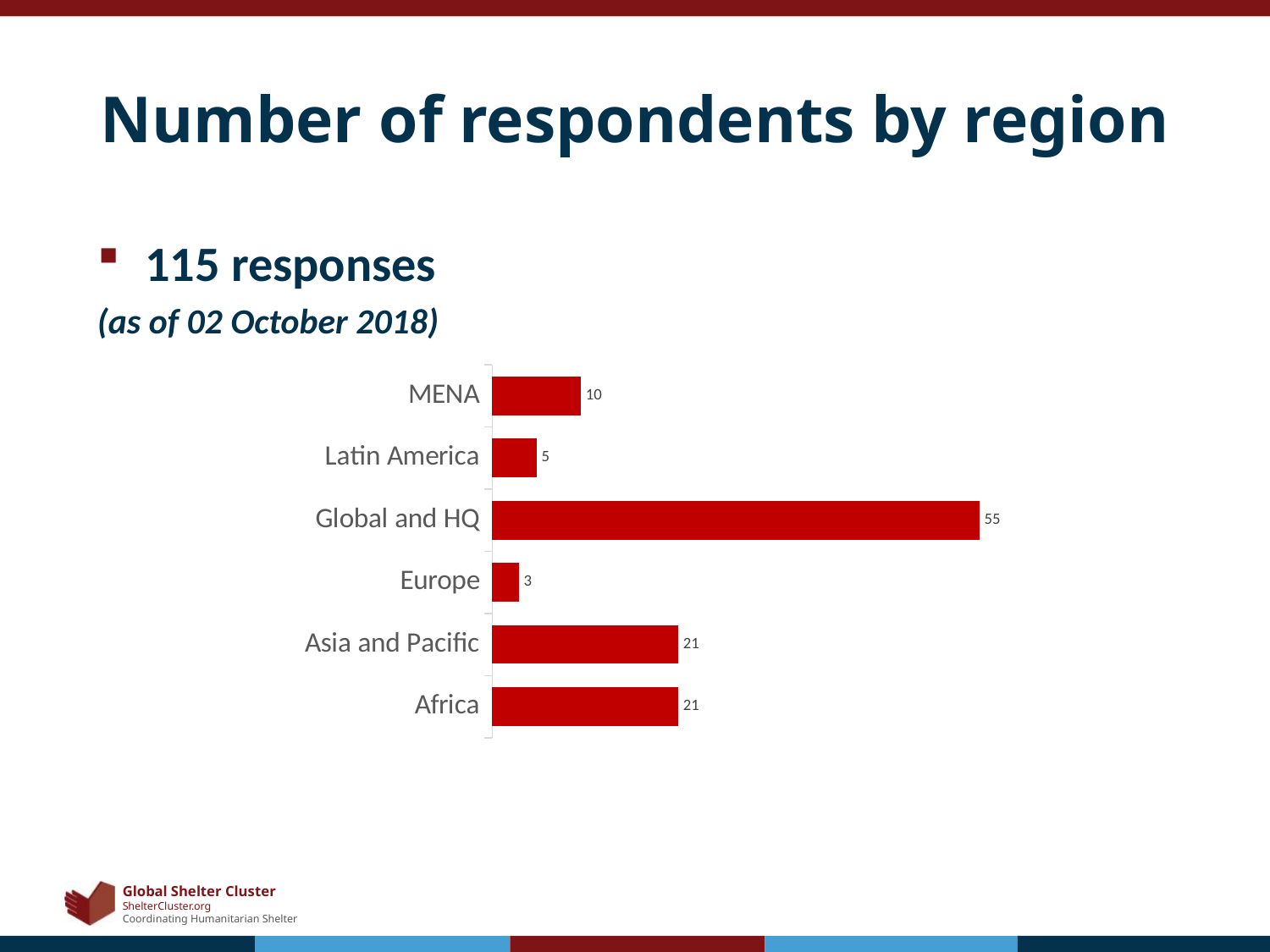
What kind of chart is shown on the slide? Bar chart How many regions are shown in the chart? 6 Which region has the highest number of respondents? Global and HQ Which region has the lowest number of respondents? Europe What is the difference between the number of respondents for Global and HQ and for Asia and Pacific? 34 What is the number of respondents for MENA? 10 What is the difference between the number of respondents for MENA and for Latin America? 5 What is the title of the slide containing the chart? Number of respondents by region Which has more respondents, MENA or Latin America? MENA What is the number of respondents for Global and HQ? 55 What is the number of respondents for Latin America? 5 What is the number of respondents for Europe? 3